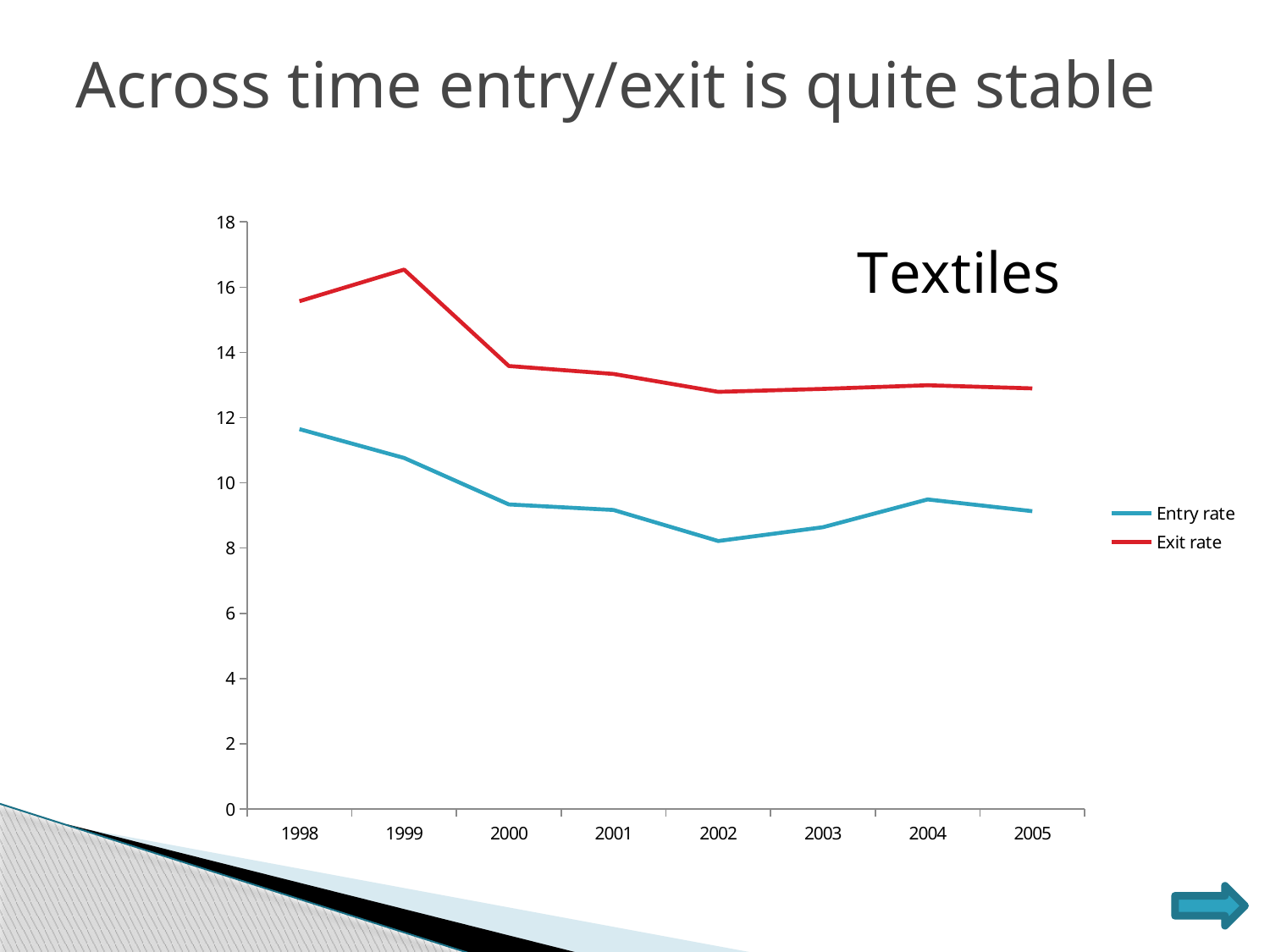
Is the Exit rate in 1999 greater or less than 16? greater In which year is the Entry rate highest? 1998 How many years are shown on the x axis? 8 In which year is the Entry rate lowest? 2002 Is the Entry rate in 2002 greater or less than 10? less Which is larger in 2000, the Entry rate or the Exit rate? Exit rate What colour is the Exit rate line? Red In which year is the Exit rate highest? 1999 What kind of chart is shown on the slide? Line chart Is the Exit rate in 2002 greater or less than 14? less How many series does the legend list? 2 Does the Exit rate rise or fall overall from 1998 to 2005? Fall